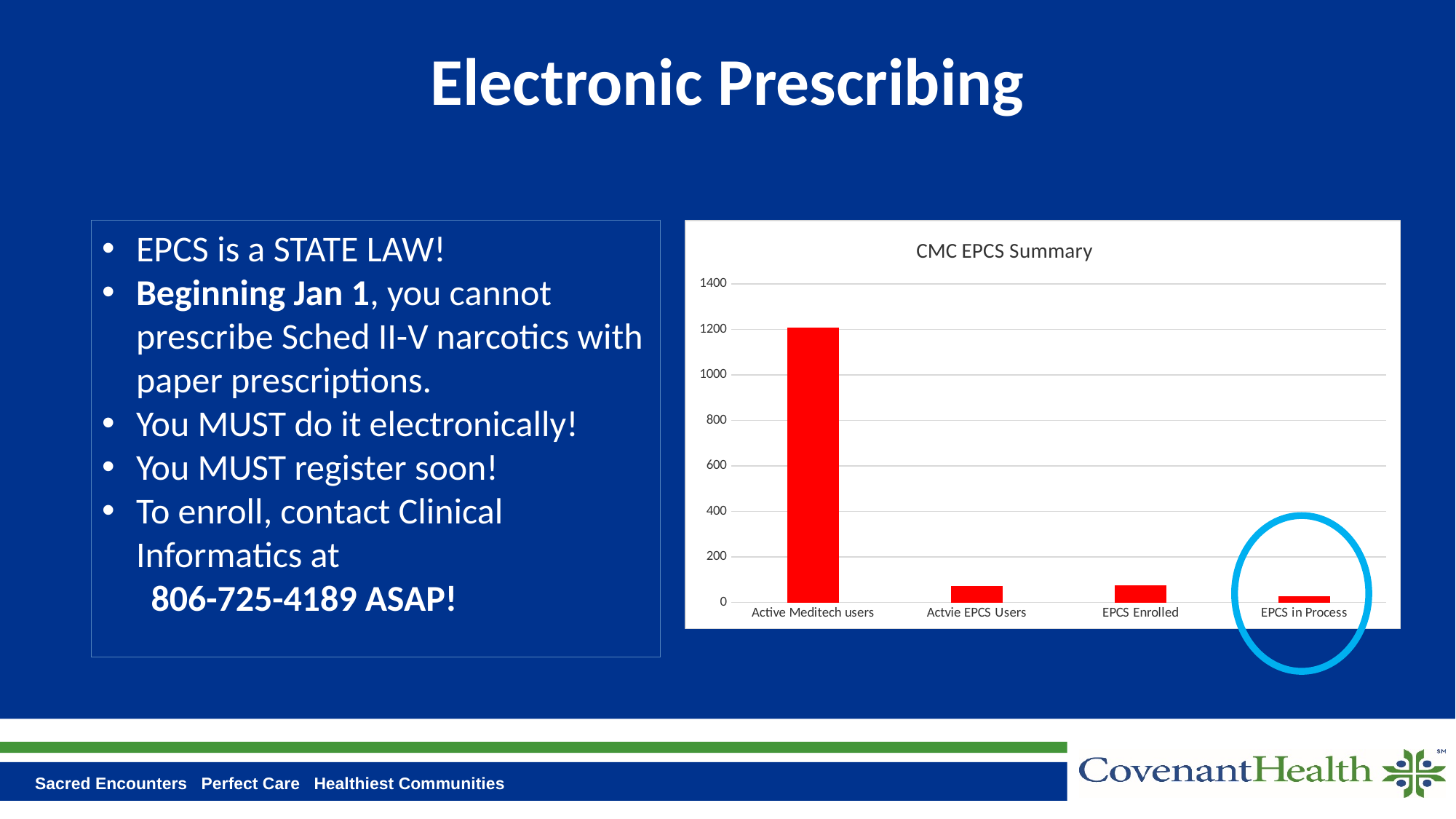
Which is larger in the CMC EPCS Summary chart, EPCS Enrolled or EPCS in Process? EPCS Enrolled How many categories are shown in the CMC EPCS Summary chart? 4 Which category in the CMC EPCS Summary chart is circled in blue? EPCS in Process Is the value for Active Meditech users greater or less than 1400? less What is the title of the chart on the slide? CMC EPCS Summary Is the value for Actvie EPCS Users greater or less than 200? less Which category has the highest value in the CMC EPCS Summary chart? Active Meditech users Is the value for Active Meditech users greater or less than 1000? greater Which category has the lowest value in the CMC EPCS Summary chart? EPCS in Process What kind of chart is the CMC EPCS Summary? Bar chart Which is larger in the CMC EPCS Summary chart, Active Meditech users or EPCS Enrolled? Active Meditech users